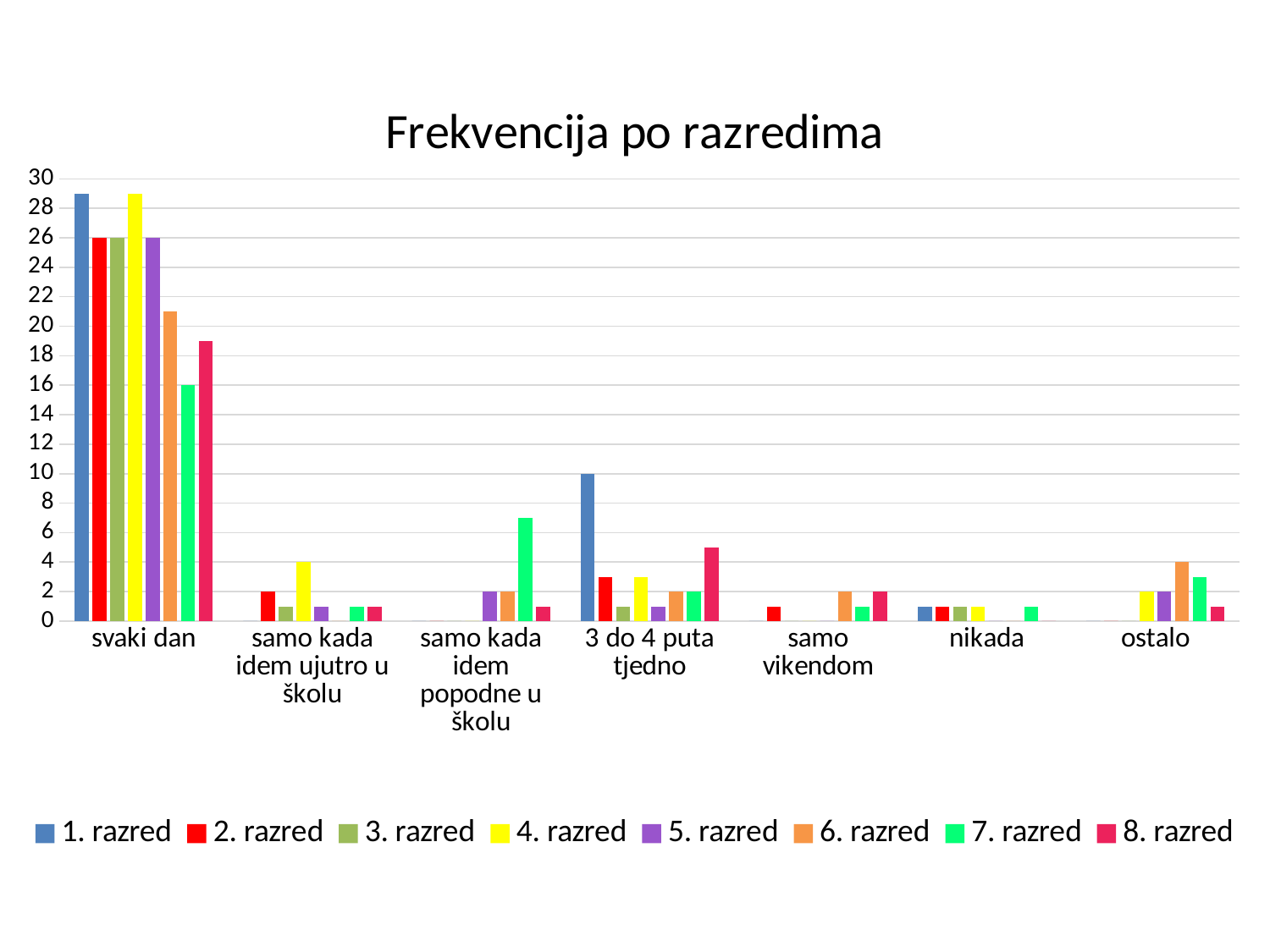
How many categories are shown on the x axis? 7 What is the value for 6. razred in the category 'ostalo'? 4 What is the difference between the value for 2. razred and the value for 7. razred in the category 'svaki dan'? 10 What is the value for 7. razred in the category 'svaki dan'? 16 What is the title of the chart? Frekvencija po razredima Is the value for 6. razred in the category 'svaki dan' greater or less than 24? less What is the value for 1. razred in the category '3 do 4 puta tjedno'? 10 How many series does the legend list? 8 In the category 'svaki dan', which is larger: the value for 1. razred or the value for 7. razred? 1. razred What is the value for 4. razred in the category 'samo kada idem ujutro u školu'? 4 Which series has the lowest value in the category 'svaki dan'? 7. razred What kind of chart is shown on the slide? bar chart